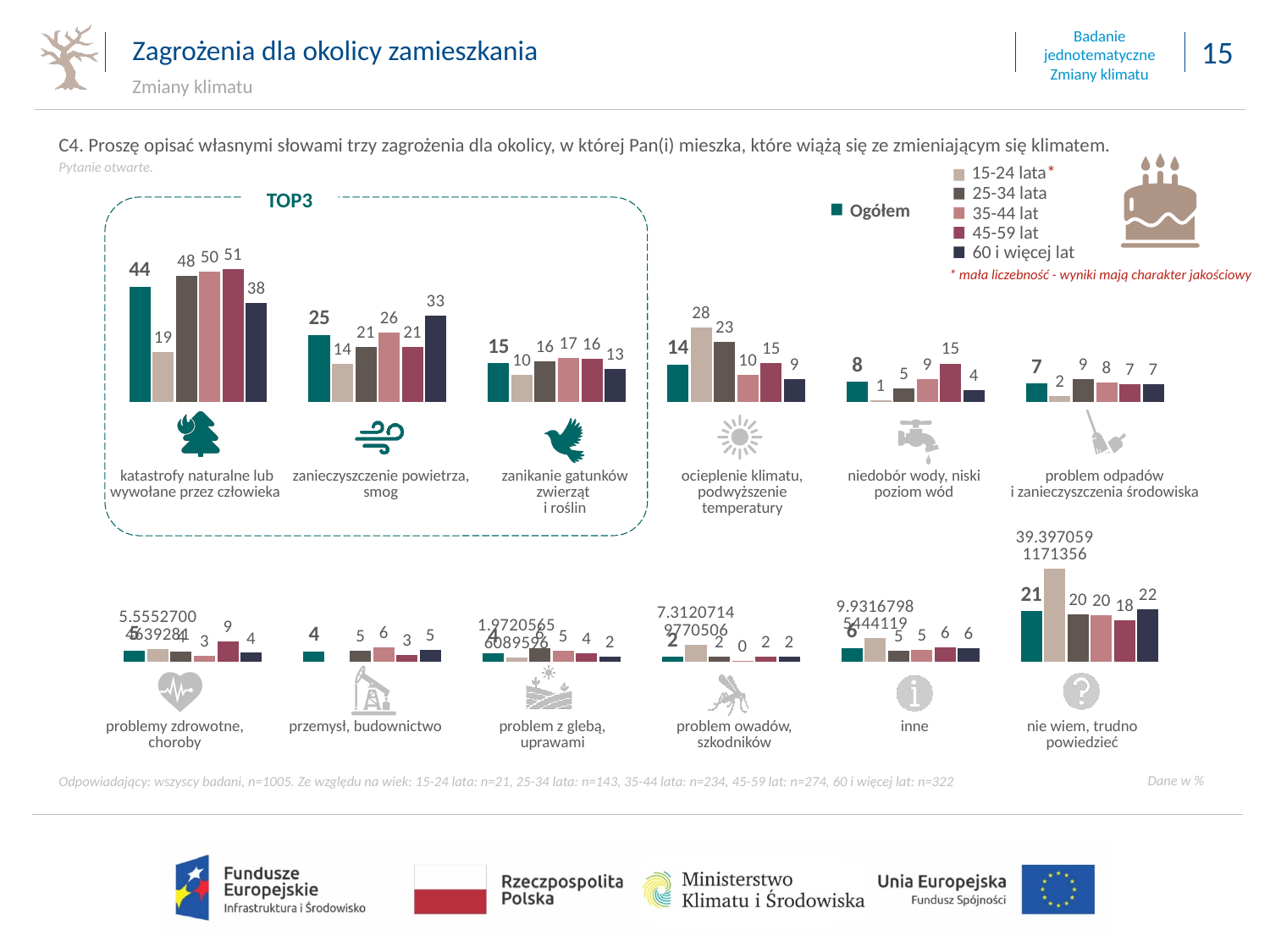
Which category has the highest Ogółem value? katastrofy naturalne lub wywołane przez człowieka What is the value for '45-59 lat' in the category 'niedobór wody, niski poziom wód'? 15 How many categories are enclosed in the dashed 'TOP3' box? 3 In 'ocieplenie klimatu, podwyższenie temperatury', which is larger: the '15-24 lata' value or the '25-34 lata' value? 15-24 lata Which category has the lowest Ogółem value? problem owadów, szkodników How many response categories are shown in the chart? 12 What kind of chart is shown on the slide? bar chart In 'katastrofy naturalne lub wywołane przez człowieka', what is the difference between the '45-59 lat' value and the '15-24 lata' value? 32 How many series does the legend list? 6 What is the Ogółem value for 'nie wiem, trudno powiedzieć'? 21 What is the Ogółem value for 'katastrofy naturalne lub wywołane przez człowieka'? 44 What is the value for '60 i więcej lat' in the category 'zanieczyszczenie powietrza, smog'? 33